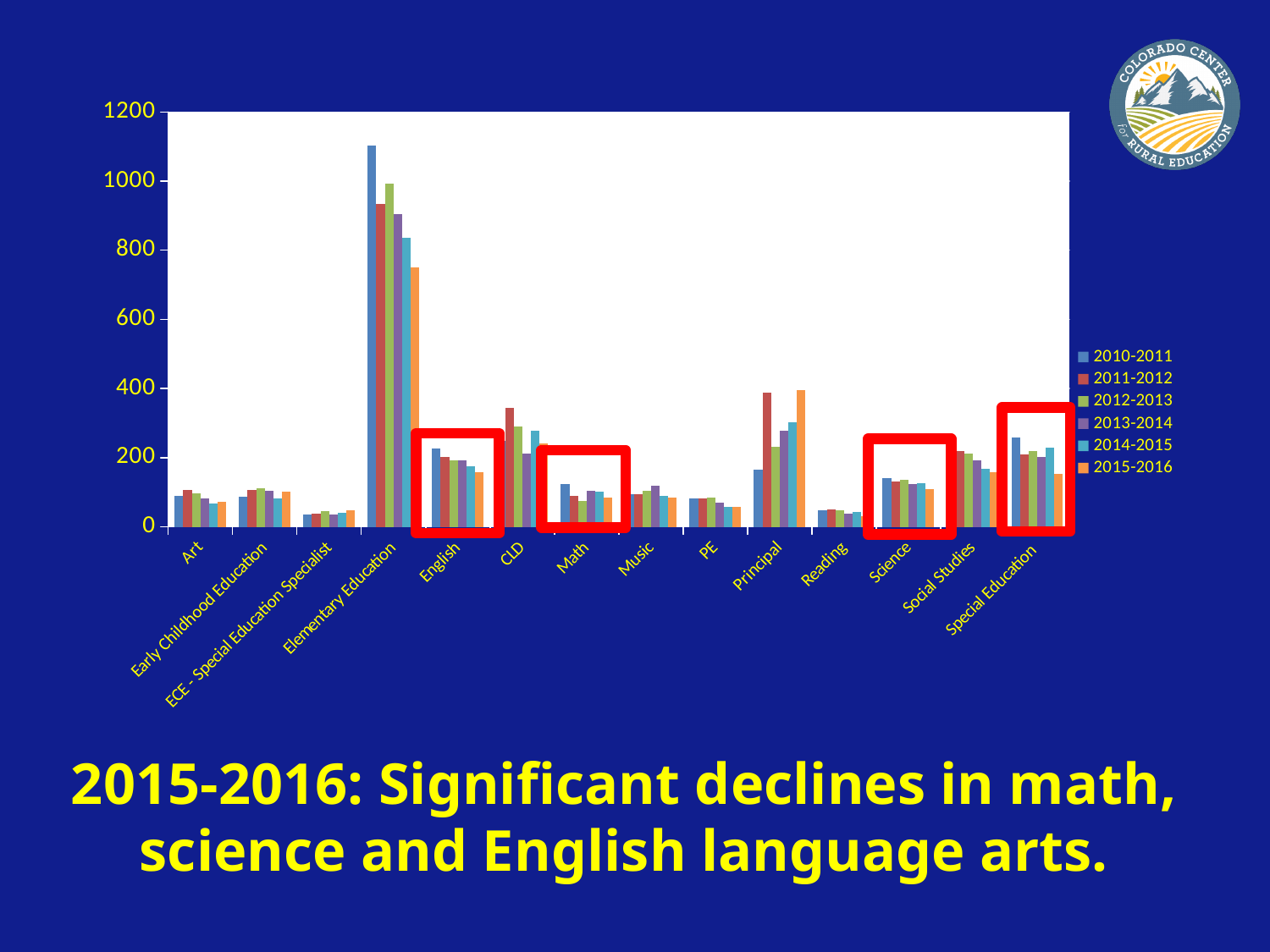
For Principal, which is larger: the 2010-2011 value or the 2015-2016 value? 2015-2016 How many categories are shown along the x axis of the chart? 14 Is the 2010-2011 value for Elementary Education greater or less than 1000? greater Is the 2010-2011 value for Art greater or less than 200? less Is the 2011-2012 value for CLD greater or less than 200? greater For Elementary Education, which is larger: the 2010-2011 value or the 2015-2016 value? 2010-2011 How many series does the chart's legend list? 6 Which categories on the chart are highlighted with red boxes? English, Math, Science, Special Education Which category has the highest bars in the chart? Elementary Education What kind of chart is shown on the slide? Bar chart